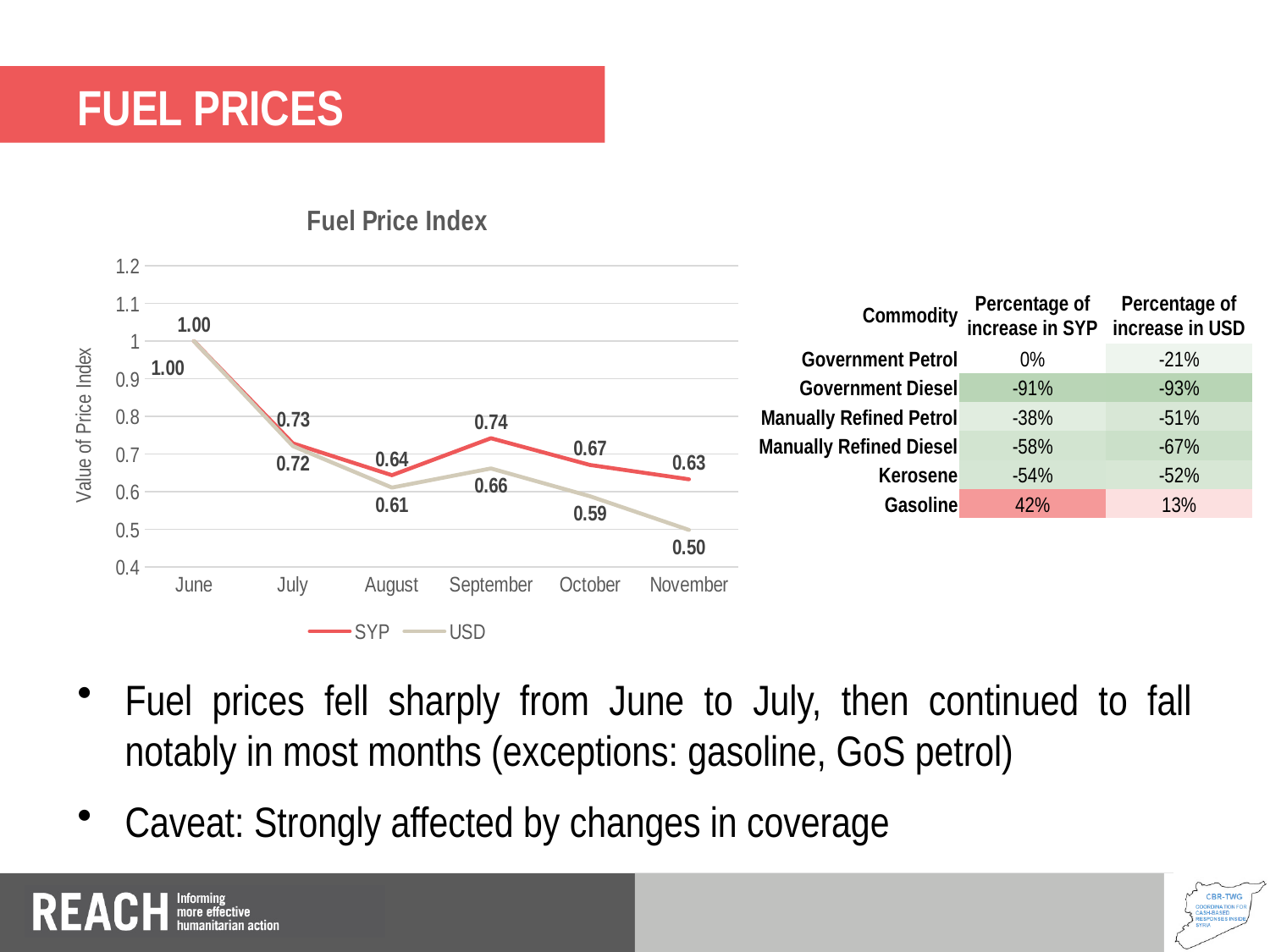
What is the y-axis title of the Fuel Price Index chart? Value of Price Index Does the USD series of the Fuel Price Index generally rise or fall from June to November? fall In which month is the SYP series of the Fuel Price Index highest? June What is the USD value of the Fuel Price Index in August? 0.61 In October, which series of the Fuel Price Index has the higher value, SYP or USD? SYP What is the difference between the SYP and USD values of the Fuel Price Index in November? 0.13 How many series does the legend of the Fuel Price Index chart list? 2 What is the SYP value of the Fuel Price Index in September? 0.74 What type of chart is the Fuel Price Index chart? line chart How many months are plotted on the x axis of the Fuel Price Index chart? 6 What is the USD value of the Fuel Price Index in November? 0.50 In which month is the USD series of the Fuel Price Index lowest? November